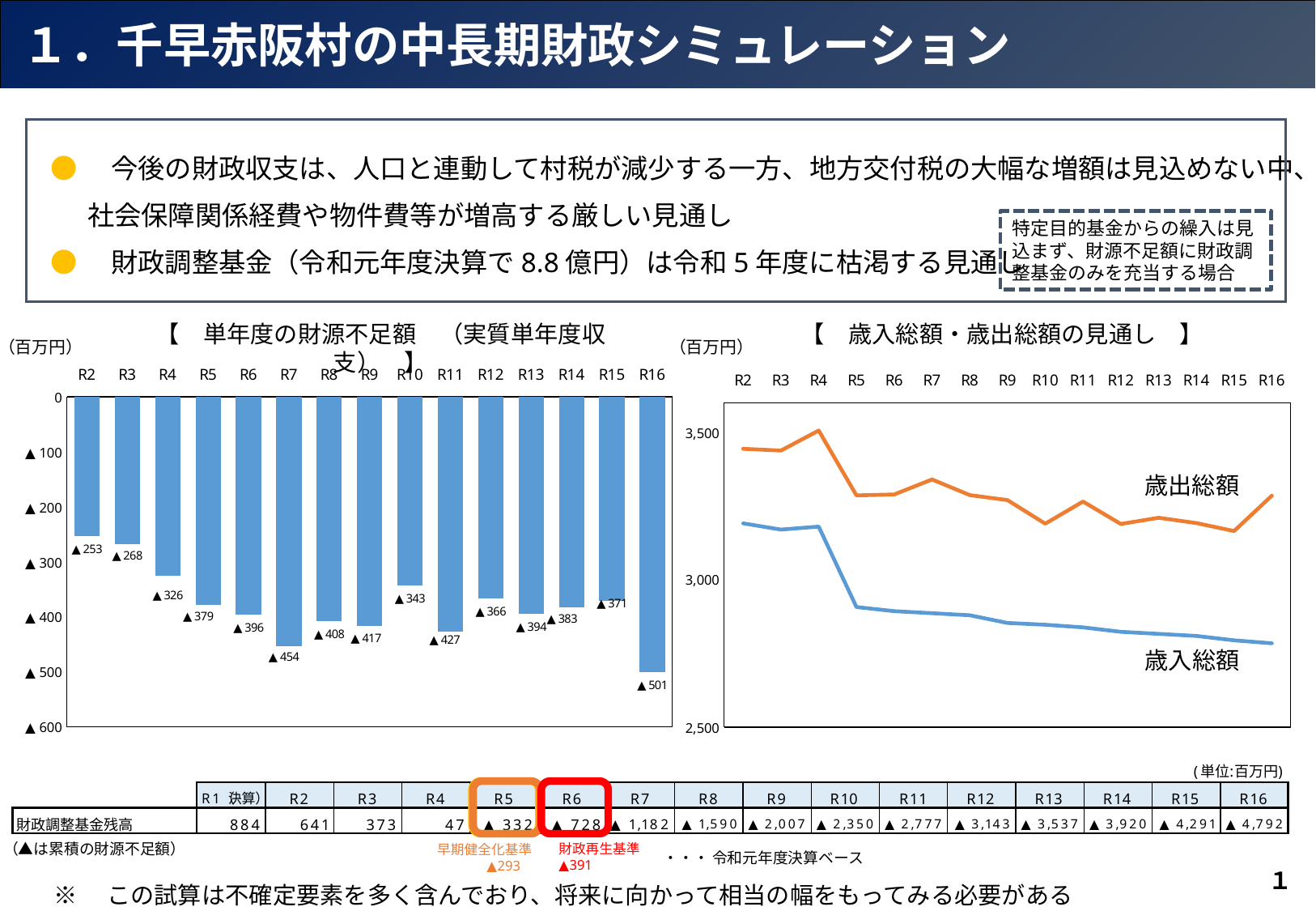
What kind of chart is the left chart (単年度の財源不足額)? Bar chart In the left chart (単年度の財源不足額), which bar is longer, R10 or R11? R11 In the left chart (単年度の財源不足額), what is the difference between the values for R16 and R2? 248 In the left chart (単年度の財源不足額), which year has the smallest shortfall (shortest bar)? R2 In the left chart (単年度の財源不足額), which year has the largest shortfall (longest bar)? R16 In the right chart (歳入総額・歳出総額の見通し), does 歳入総額 generally rise or fall from R2 to R16? Fall In the left chart (単年度の財源不足額), what is the value for R16? ▲501 In the left chart (単年度の財源不足額), what is the value for R7? ▲454 In the right chart (歳入総額・歳出総額の見通し), how many series are plotted? 2 How many bars are plotted in the left chart (単年度の財源不足額)? 15 In the left chart (単年度の財源不足額), what is the value for R2? ▲253 In the right chart (歳入総額・歳出総額の見通し), is the value of 歳入総額 for R16 greater or less than 3,000? less